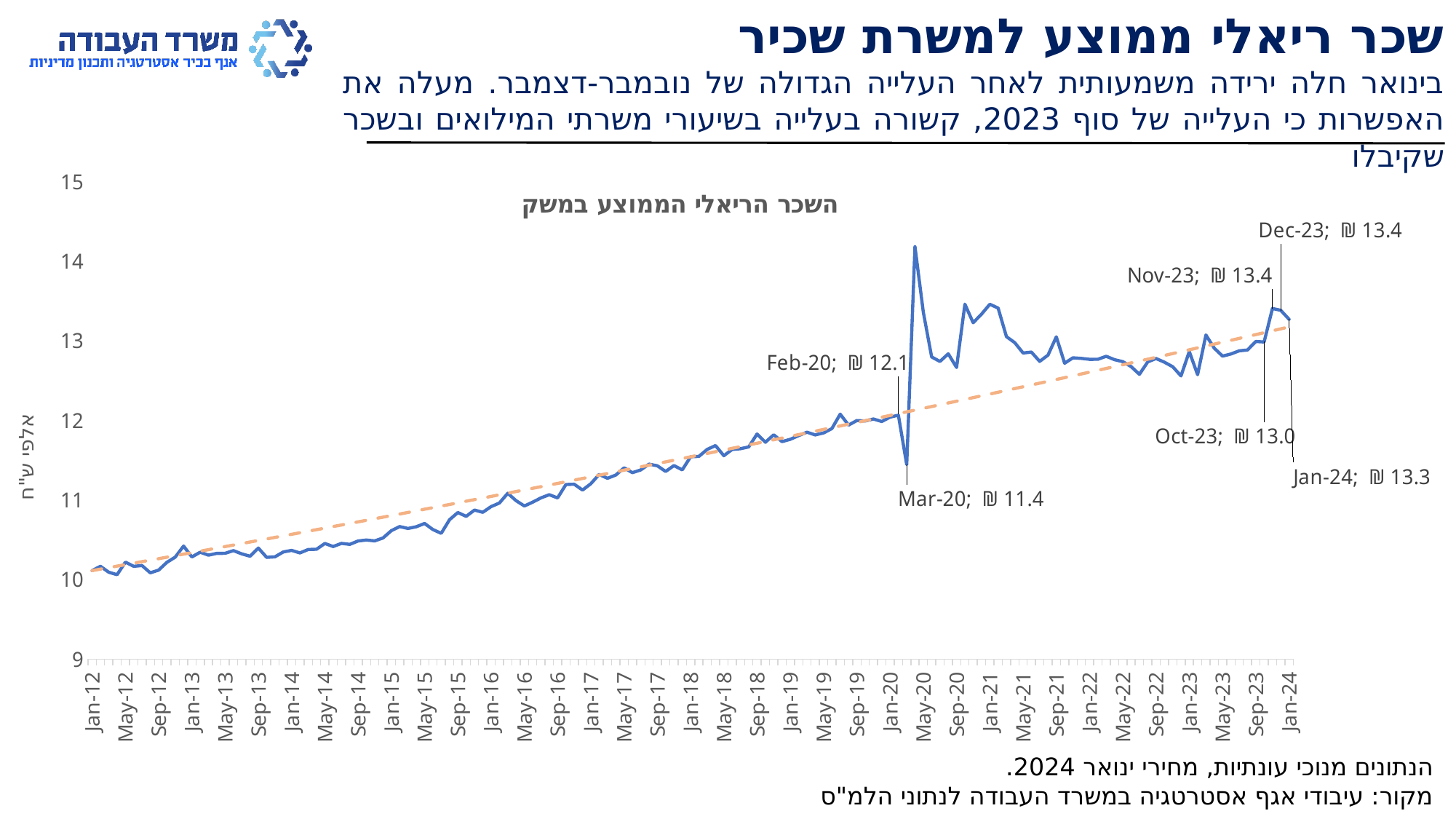
What is the value labelled for Jan-24? ₪ 13.3 What is the value labelled for Mar-20? ₪ 11.4 Overall, does the solid line rise or fall from Jan-12 to Jan-24? rise What is the unit shown on the y-axis label? אלפי ש"ח Is the value for Jan-12 greater or less than 11? less What is the difference between the labelled values for Nov-23 and Oct-23? ₪ 0.4 What is the value labelled for Feb-20? ₪ 12.1 Which is larger, the labelled value for Dec-23 or for Jan-24? Dec-23 What is the difference between the labelled values for Feb-20 and Mar-20? ₪ 0.7 Is the value for Jan-18 greater or less than 11? greater What is the value labelled for Oct-23? ₪ 13.0 What type of chart is shown on the slide? line chart